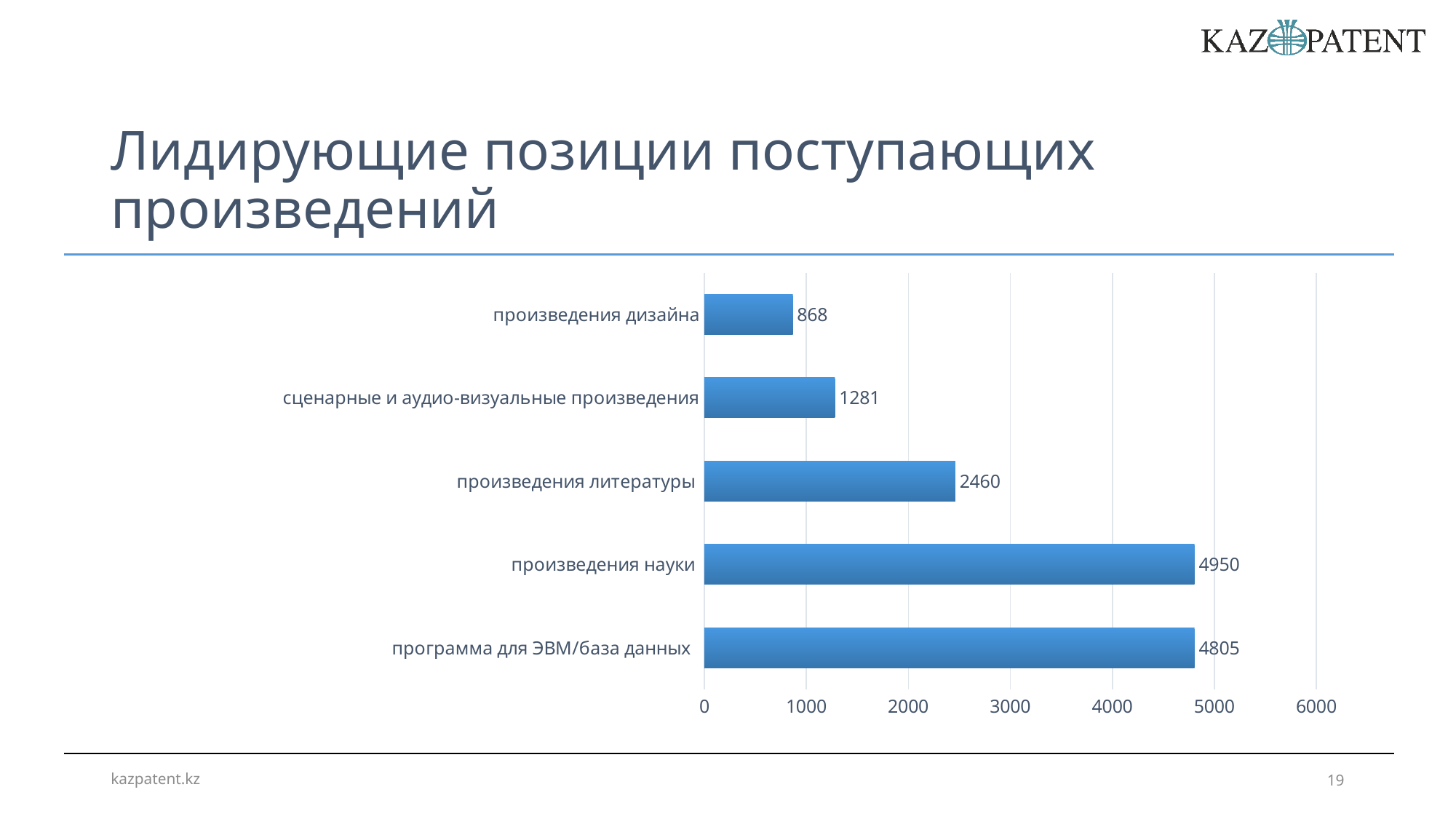
What is the value for произведения науки? 4950 What is the title of the slide containing the chart? Лидирующие позиции поступающих произведений What is the difference between произведения науки and программа для ЭВМ/база данных? 145 What is the value for сценарные и аудио-визуальные произведения? 1281 What is the value for произведения дизайна? 868 Which is larger: произведения литературы or сценарные и аудио-визуальные произведения? произведения литературы Which category has the lowest value? произведения дизайна What is the value for программа для ЭВМ/база данных? 4805 What kind of chart is shown on the slide? bar chart Which category has the highest value? произведения науки What is the difference between произведения литературы and сценарные и аудио-визуальные произведения? 1179 How many categories are shown in the chart? 5